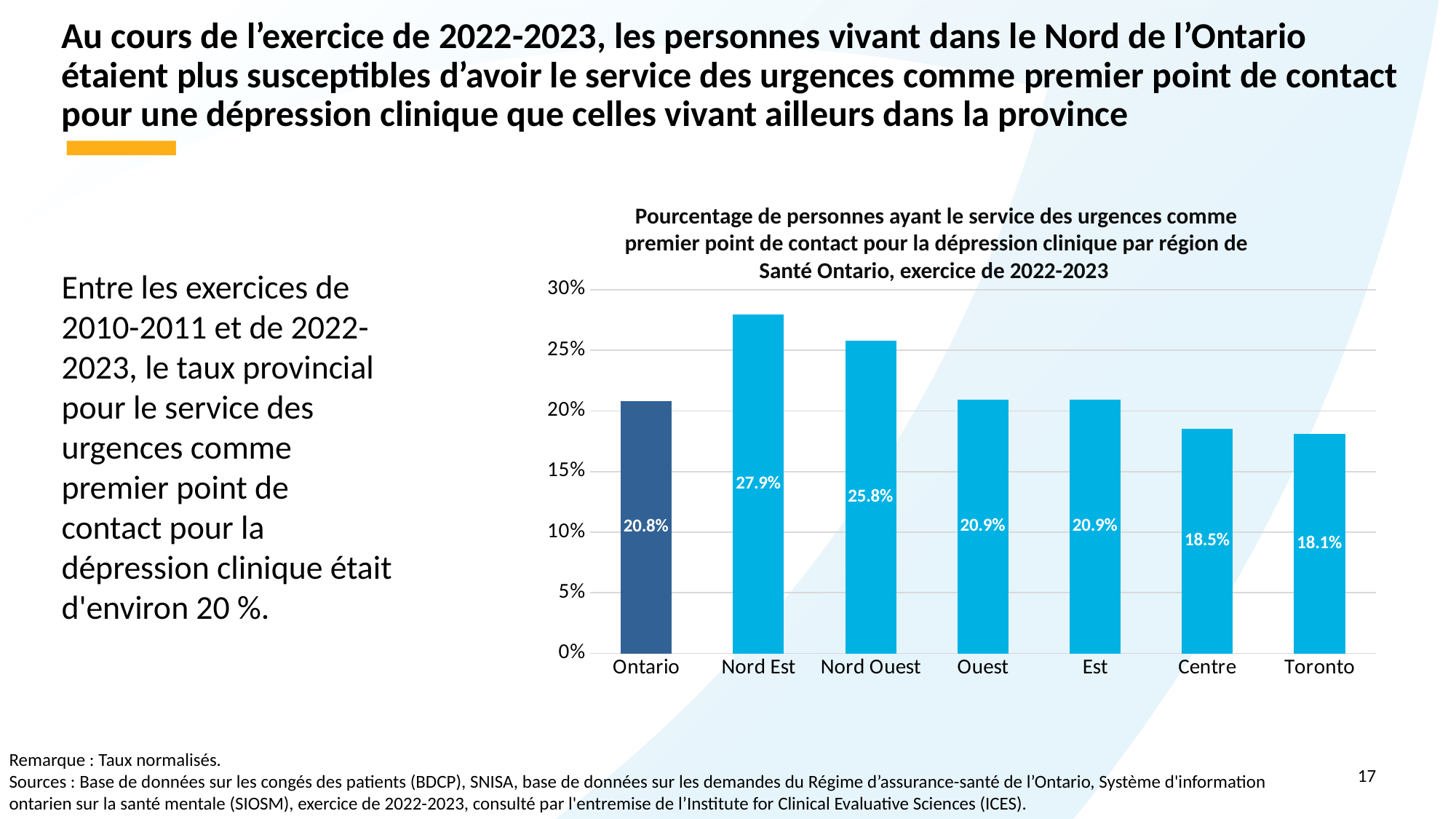
What is the value for Centre? 18.5% How many categories are shown on the x axis? 7 Which region has the highest value? Nord Est Which category has the lowest value? Toronto What kind of chart is shown on the slide? Bar chart What is the difference between the values for Nord Ouest and Toronto? 7.7% What is the value for Toronto? 18.1% Which is larger, the value for Nord Ouest or the value for Ouest? Nord Ouest What is the difference between the values for Nord Est and Ontario? 7.1% What is the value for Nord Est? 27.9% Is the value for Nord Est greater or less than 25%? greater What is the value for Ontario? 20.8%